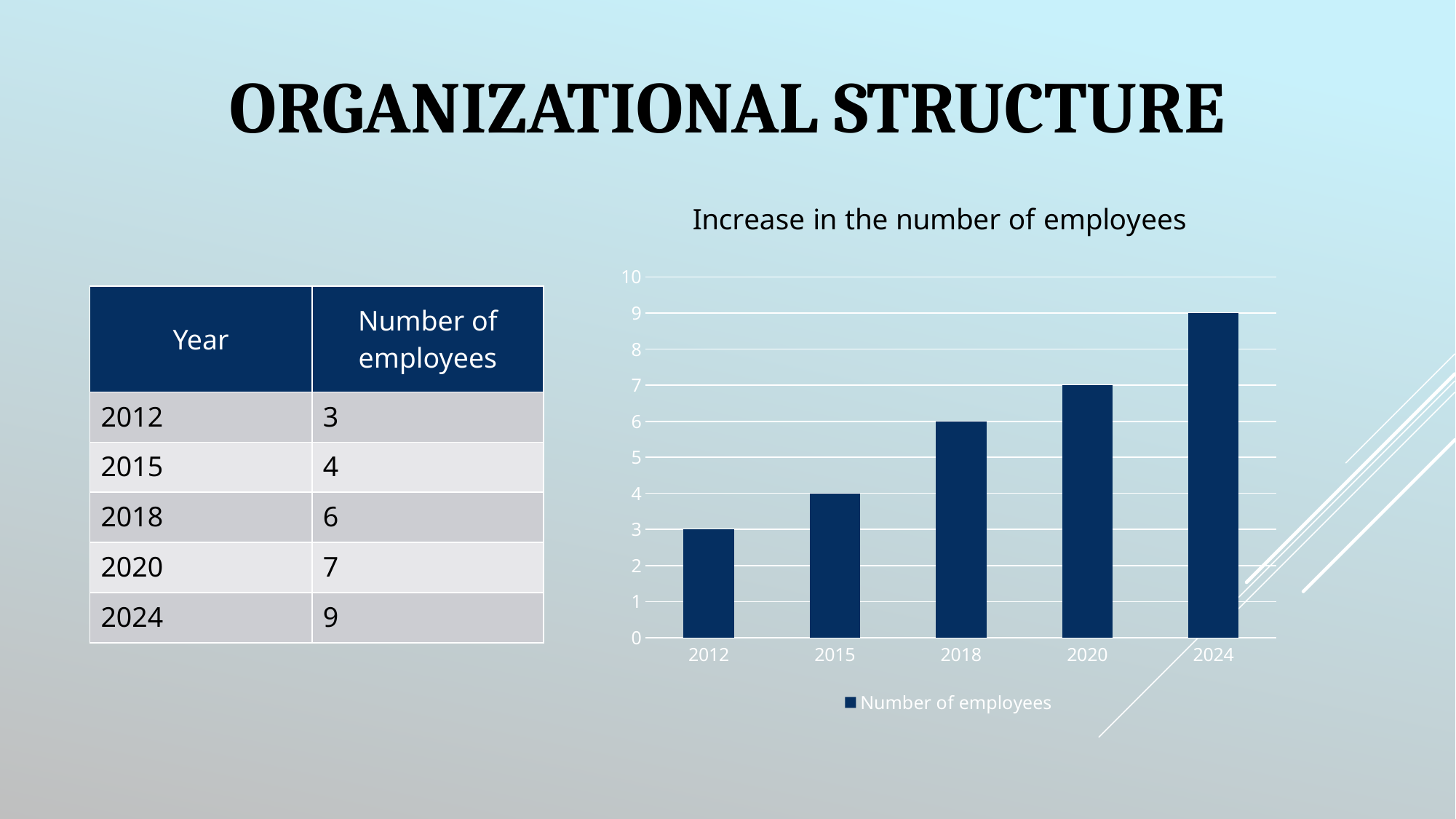
What is the number of employees in 2018? 6 What kind of chart is shown on the slide? bar chart What is the number of employees in 2012? 3 Which year has the highest number of employees? 2024 What is the difference in the number of employees between 2020 and 2015? 3 Do the values rise or fall from 2012 to 2024? rise What is the number of employees in 2024? 9 Which year has the lowest number of employees? 2012 What is the difference in the number of employees between 2024 and 2012? 6 Which year has more employees, 2015 or 2020? 2020 How many years are shown on the x axis of the chart? 5 Is the number of employees in 2020 greater or less than 5? greater